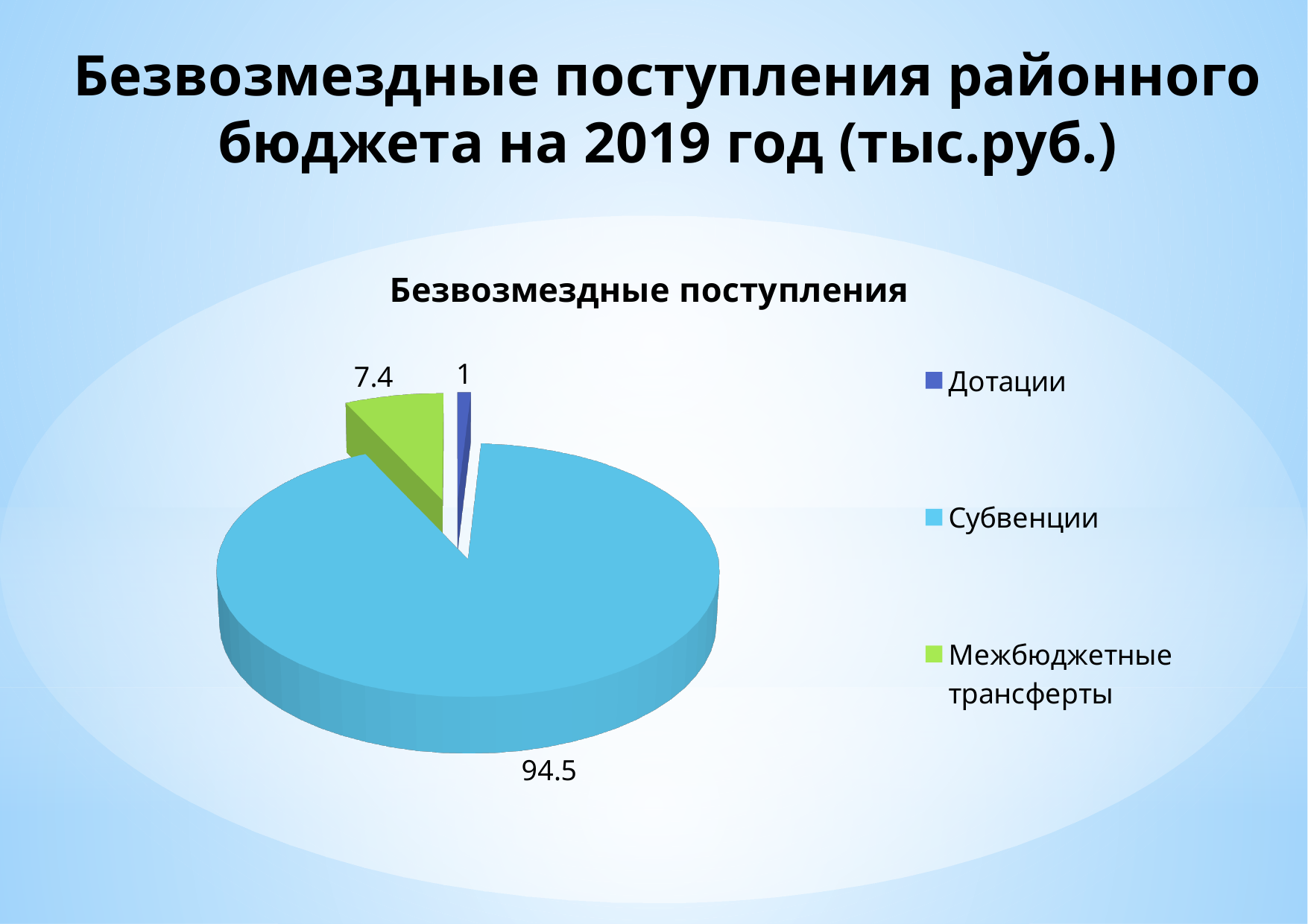
Which is larger, the value for Межбюджетные трансферты or the value for Дотации? Межбюджетные трансферты What is the difference between the values for Межбюджетные трансферты and Дотации? 6.4 What colour is the slice for Межбюджетные трансферты? Green How many slices does the pie chart have? 3 What is the value for Субвенции in the pie chart? 94.5 What is the value for Дотации in the pie chart? 1 What is the difference between the values for Субвенции and Межбюджетные трансферты? 87.1 What is the title of the chart? Безвозмездные поступления What is the value for Межбюджетные трансферты in the pie chart? 7.4 What kind of chart is shown on the slide? Pie chart Which category has the largest slice in the pie chart? Субвенции Which category has the smallest slice in the pie chart? Дотации